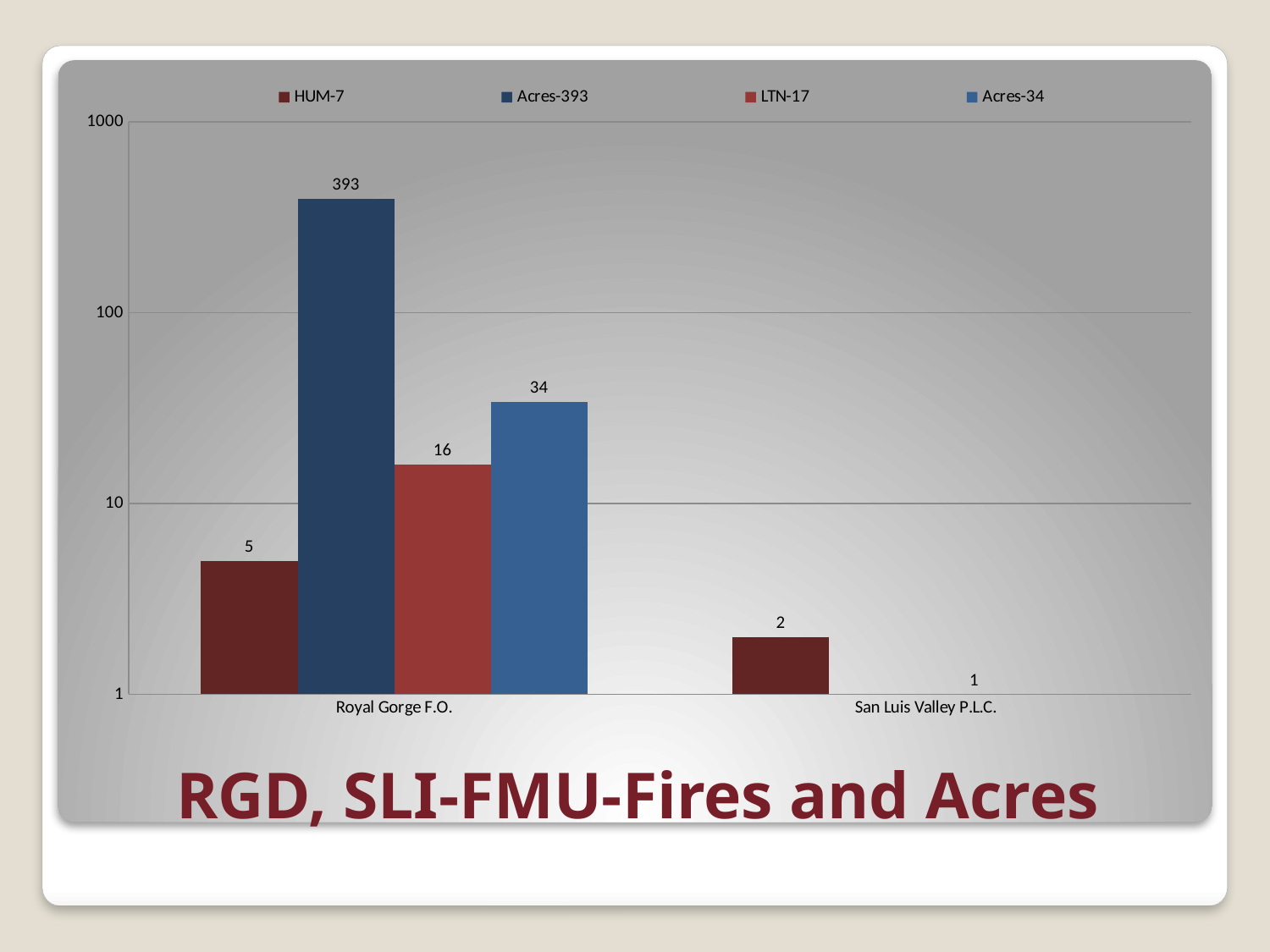
What is the value of the Acres-393 bar for Royal Gorge F.O.? 393 Which category has the larger HUM-7 value, Royal Gorge F.O. or San Luis Valley P.L.C.? Royal Gorge F.O. What is the difference between the Acres-34 value and the LTN-17 value for Royal Gorge F.O.? 18 Which series has the highest value for Royal Gorge F.O.? Acres-393 What is the value of the HUM-7 bar for San Luis Valley P.L.C.? 2 How many categories are shown on the x axis? 2 What kind of chart is shown on the slide? bar chart What is the value of the Acres-34 bar for Royal Gorge F.O.? 34 Is the Acres-393 value for Royal Gorge F.O. greater or less than 100? greater How many series does the legend list? 4 What is the value of the LTN-17 bar for Royal Gorge F.O.? 16 What is the value of the HUM-7 bar for Royal Gorge F.O.? 5